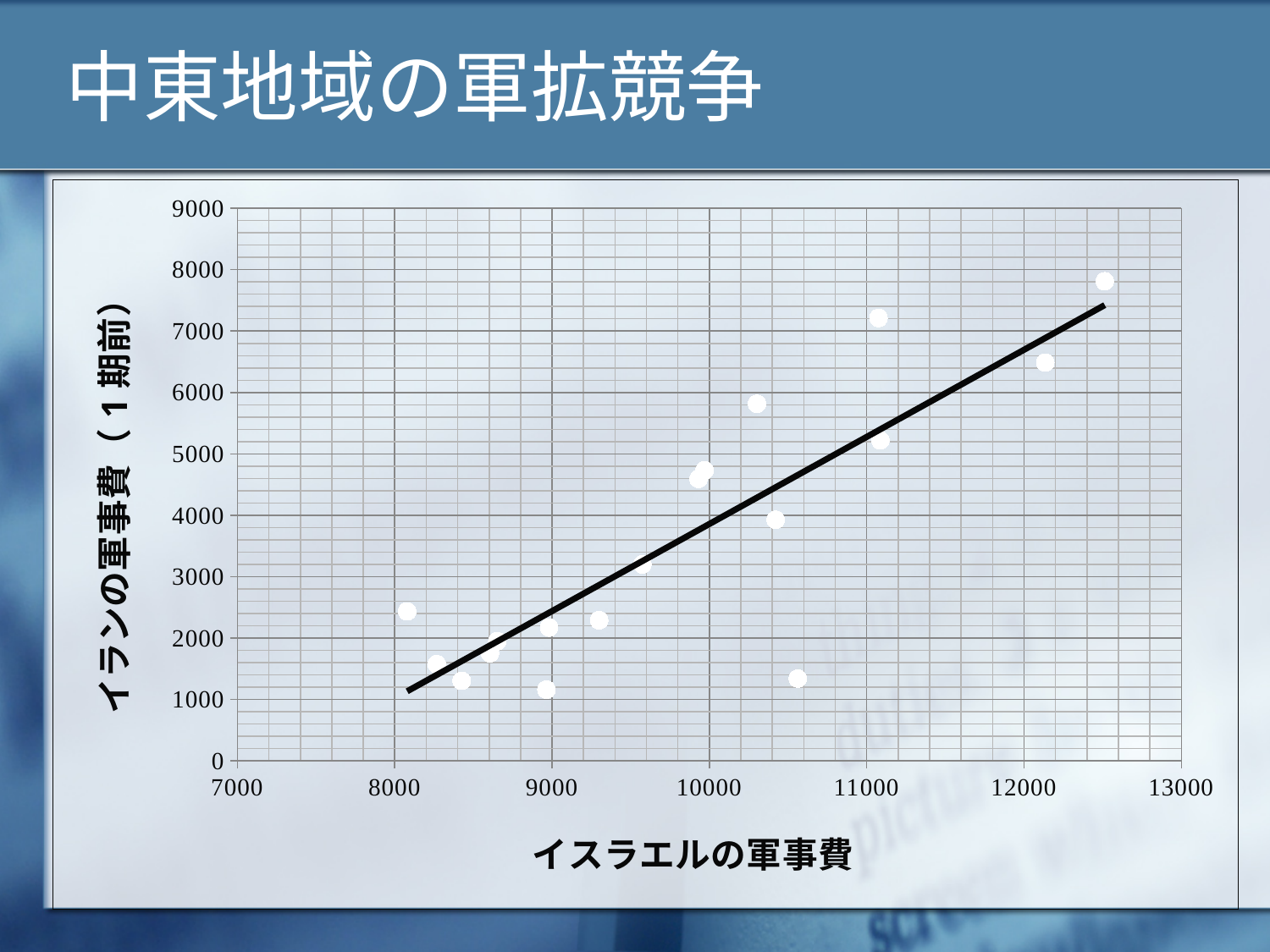
Is the y value of the point near x = 10300 greater or less than 5000? greater Is the point with the highest Iran military spending also the point with the highest Israel military spending? yes Is the y value of the point near x = 10550 greater or less than 3000? less Is the y value of the rightmost point (highest Israel spending) greater or less than 7000? greater What is the label of the y axis? イランの軍事費（1期前） As Israel's military spending (x axis) increases, does Iran's military spending generally rise or fall? rise Does the trend line slope upward or downward from left to right? upward What is the maximum value shown on the x axis? 13000 What kind of chart is shown on the slide? scatter chart What is the label of the x axis? イスラエルの軍事費 What is the maximum value shown on the y axis? 9000